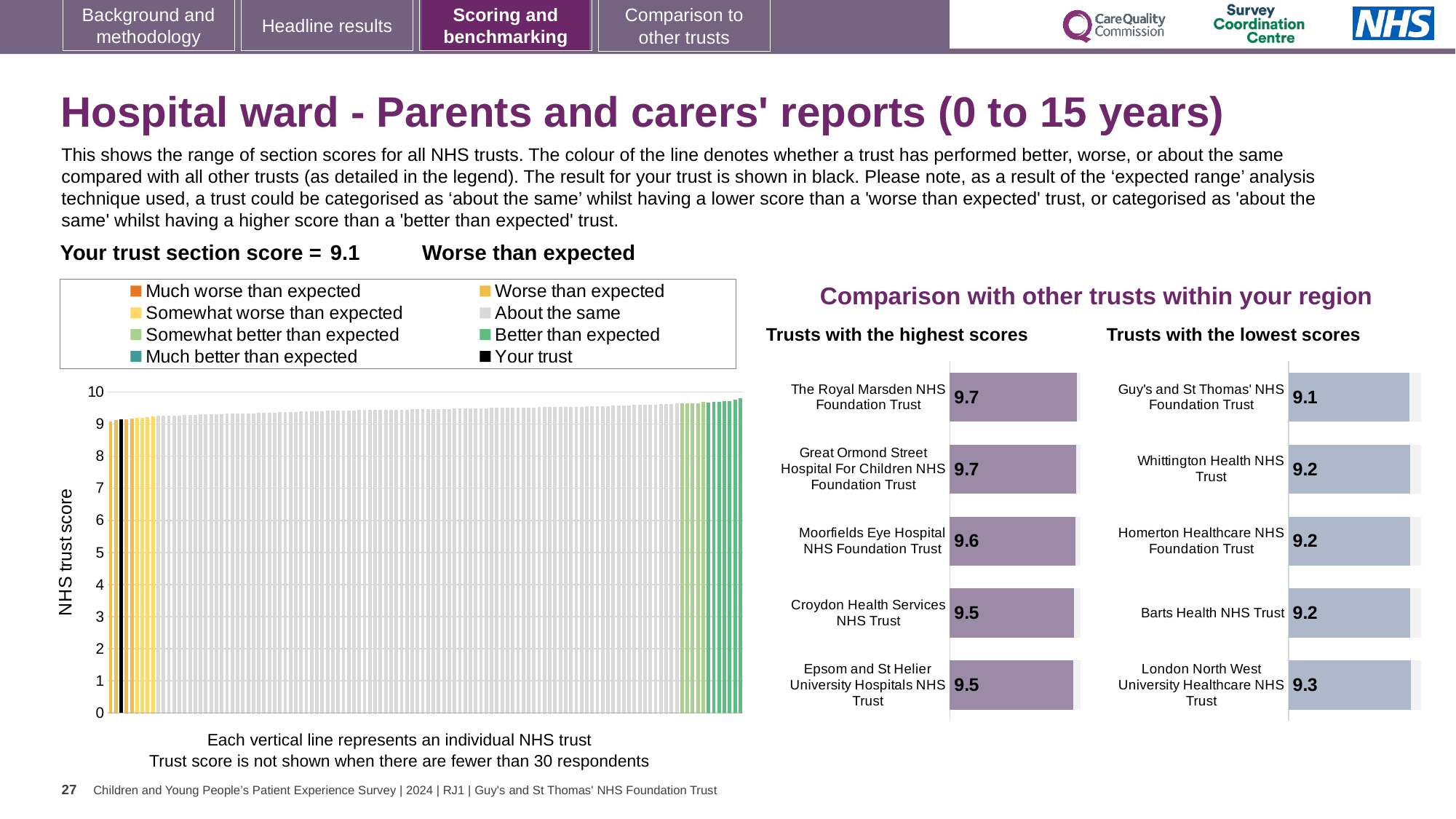
How many entries does the legend above the left chart list? 8 In the 'Trusts with the highest scores' chart, what is the score for Moorfields Eye Hospital NHS Foundation Trust? 9.6 What kind of chart is the large chart on the left showing NHS trust scores? Bar chart How many trusts are shown in the 'Trusts with the highest scores' chart? 5 In the 'Trusts with the highest scores' chart, what is the difference between the scores of The Royal Marsden NHS Foundation Trust and Croydon Health Services NHS Trust? 0.2 In the 'Trusts with the lowest scores' chart, which trust has the lowest score? Guy's and St Thomas' NHS Foundation Trust In the 'Trusts with the lowest scores' chart, what is the score for Whittington Health NHS Trust? 9.2 In the 'Trusts with the lowest scores' chart, which trust has the highest score? London North West University Healthcare NHS Trust In the 'Trusts with the lowest scores' chart, which has the larger score: Guy's and St Thomas' NHS Foundation Trust or London North West University Healthcare NHS Trust? London North West University Healthcare NHS Trust In the large chart on the left, do the bar values rise or fall from left to right along the x axis? Rise In the 'Trusts with the highest scores' chart, what is the score for The Royal Marsden NHS Foundation Trust? 9.7 How many trusts are shown in the 'Trusts with the lowest scores' chart? 5